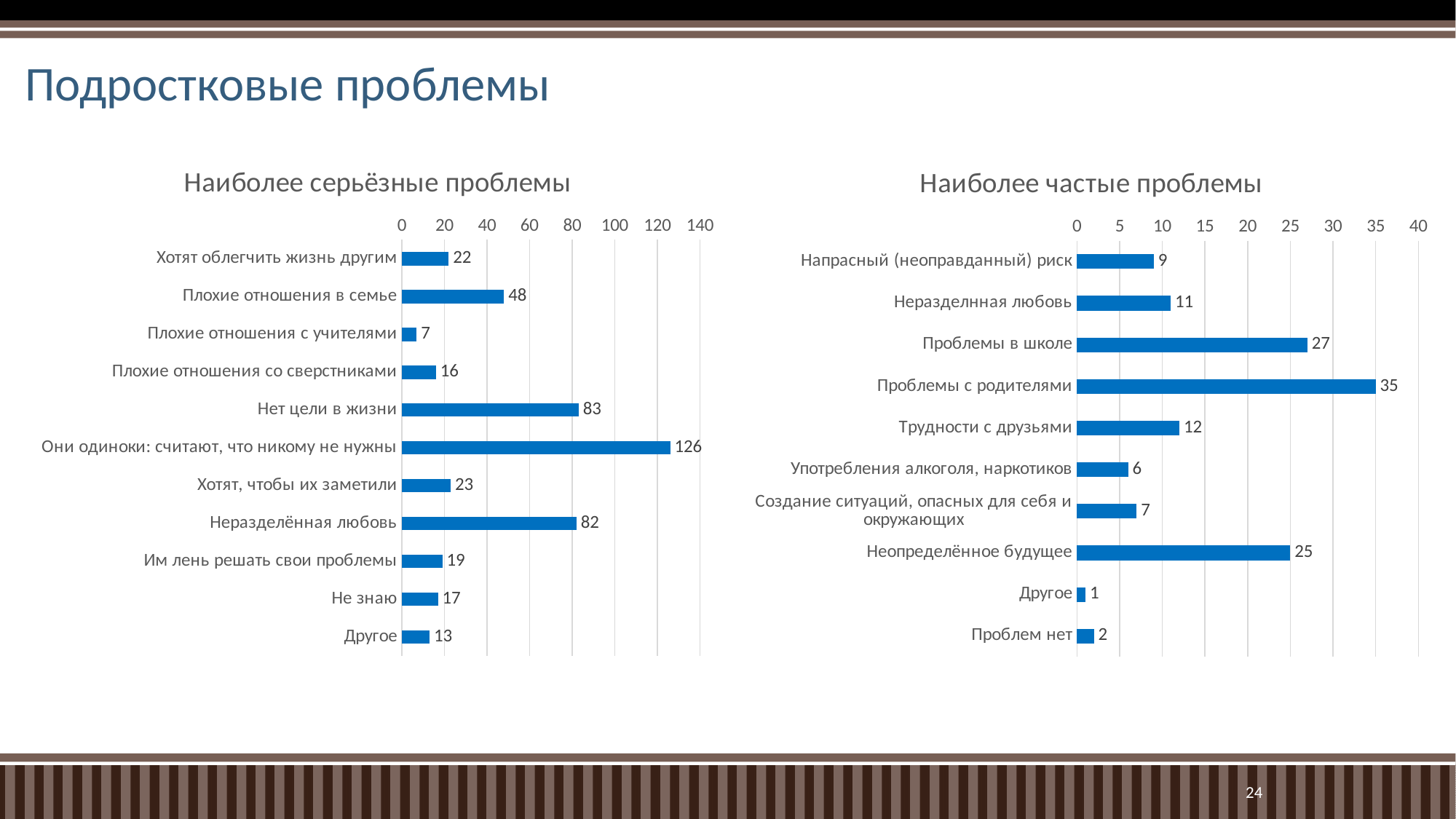
In the chart 'Наиболее серьёзные проблемы', how many categories are shown? 11 In the chart 'Наиболее серьёзные проблемы', what is the value for 'Плохие отношения в семье'? 48 In the chart 'Наиболее серьёзные проблемы', which category has the highest value? Они одиноки: считают, что никому не нужны What type of chart is 'Наиболее серьёзные проблемы'? Bar chart In the chart 'Наиболее частые проблемы', how many categories are shown? 10 In the chart 'Наиболее серьёзные проблемы', which category has the lowest value? Плохие отношения с учителями In the chart 'Наиболее частые проблемы', which category has the lowest value? Другое In the chart 'Наиболее серьёзные проблемы', what is the difference between 'Нет цели в жизни' and 'Неразделённая любовь'? 1 In the chart 'Наиболее частые проблемы', what is the value for 'Проблемы в школе'? 27 In the chart 'Наиболее частые проблемы', which is larger: 'Неразделенная любовь' or 'Трудности с друзьями'? Трудности с друзьями In the chart 'Наиболее частые проблемы', which category has the highest value? Проблемы с родителями In the chart 'Наиболее частые проблемы', what is the difference between 'Проблемы с родителями' and 'Неопределённое будущее'? 10